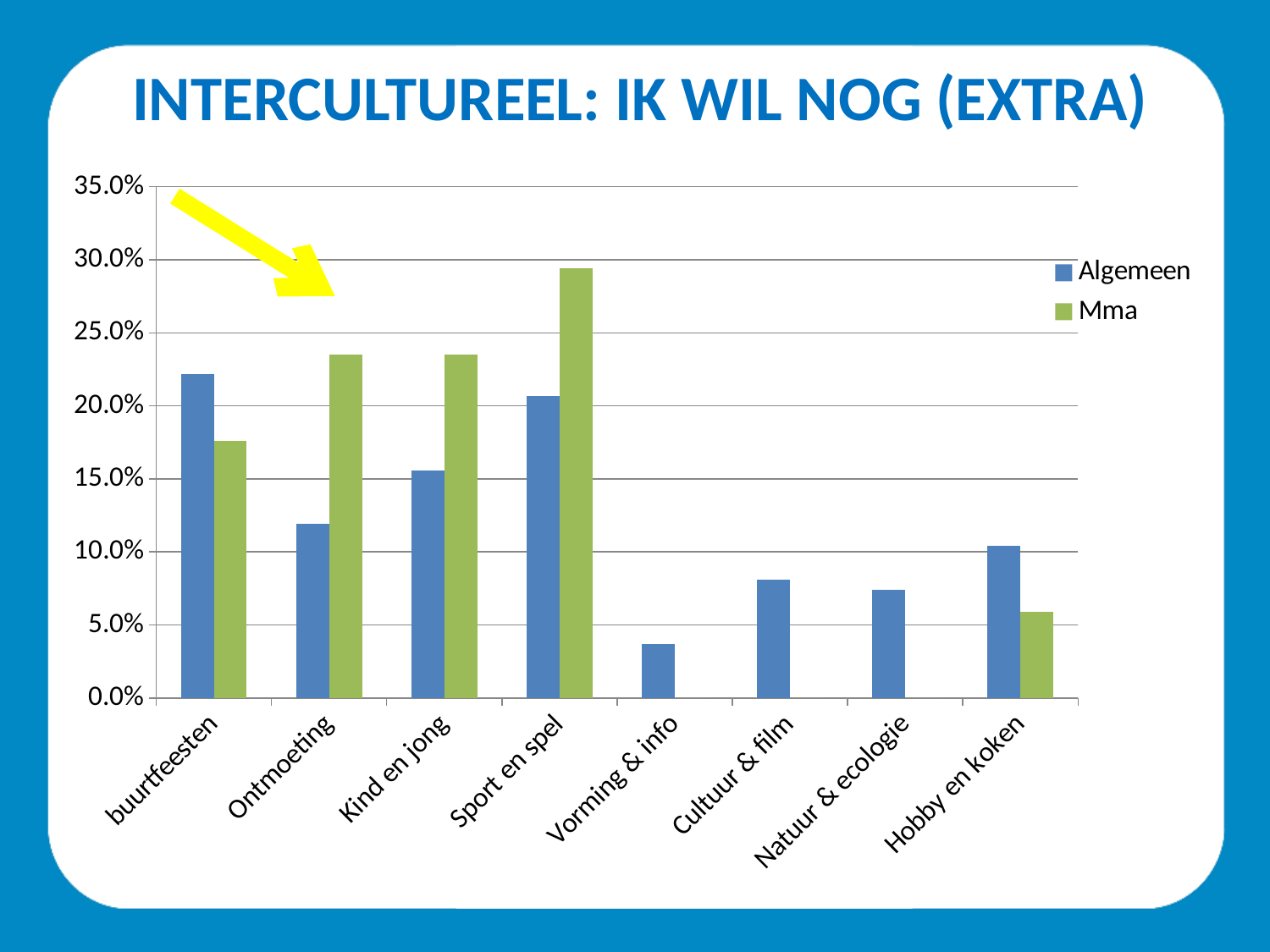
For Ontmoeting, which series has the larger value, Algemeen or Mma? Mma Is the Algemeen value for Vorming & info greater or less than 5.0%? less Is the Mma value for Hobby en koken greater or less than 10.0%? less For buurtfeesten, which series has the larger value, Algemeen or Mma? Algemeen How many series does the legend list? 2 What is the title of the slide? INTERCULTUREEL: IK WIL NOG (EXTRA) Is the Mma value for Kind en jong greater or less than 20.0%? greater Which category has the highest value for the Mma series? Sport en spel Which category has the lowest value for the Algemeen series? Vorming & info How many categories are shown on the x axis? 8 What kind of chart is shown on the slide? bar chart